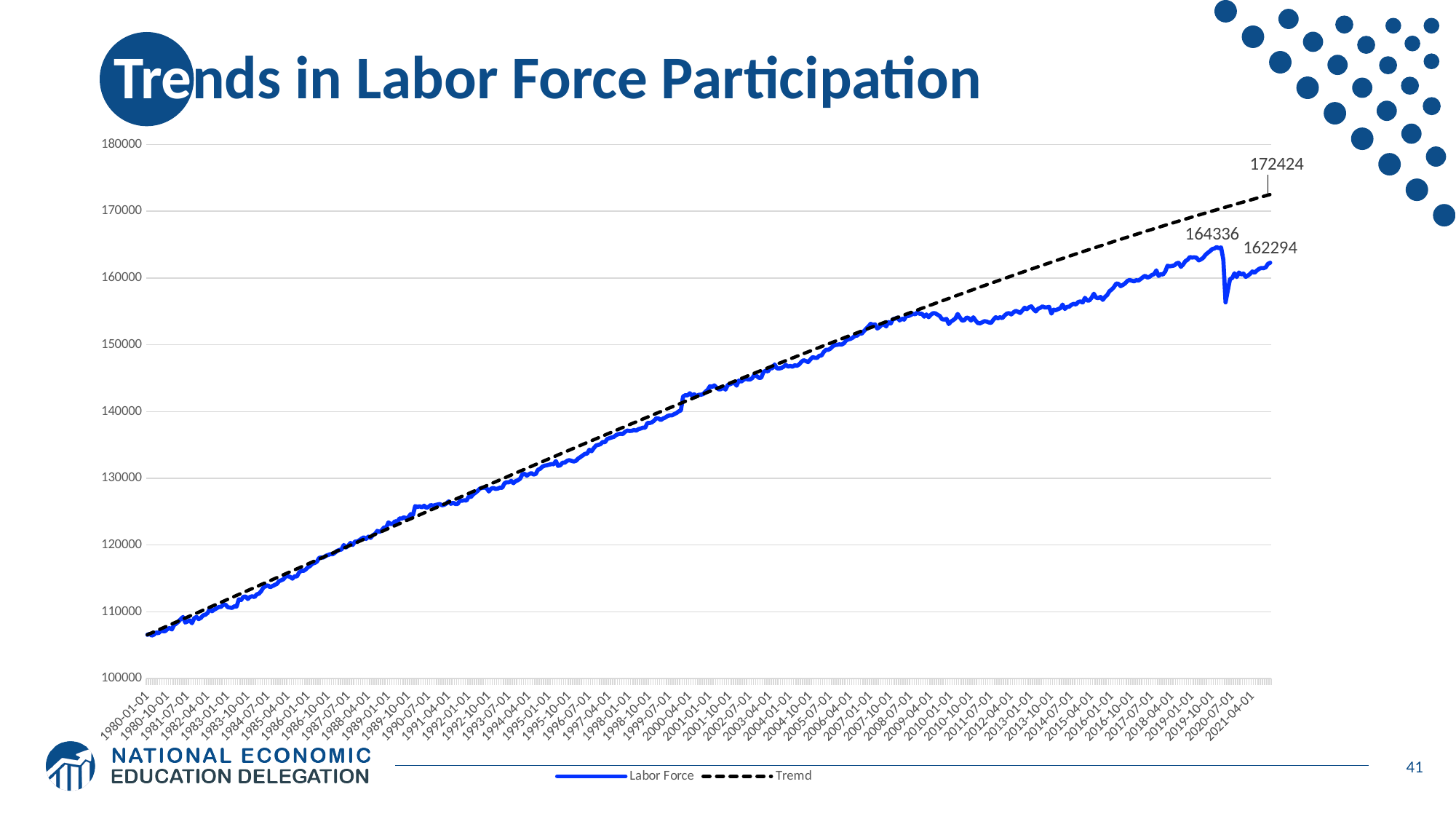
What is the labelled peak value of the Labor Force series just before the 2020 drop? 164336 Is the Labor Force value around 2010-01-01 greater or less than 160000? less What is the labelled end value of the dashed trend line? 172424 What are the two series named in the legend? Labor Force and Tremd At the right end of the chart, which is higher: the trend line or the Labor Force line? the trend line What is the difference between the Labor Force peak of 164336 and its final value of 162294? 2042 What is the difference between the trend line's end value (172424) and the Labor Force final value (162294)? 10130 Does the Labor Force series generally rise or fall from 1980 to 2021? rise How many series does the legend list? 2 What kind of chart is shown on the slide? line chart Is the Labor Force value around 1990-01-01 greater or less than 120000? greater What is the labelled final value of the Labor Force series? 162294